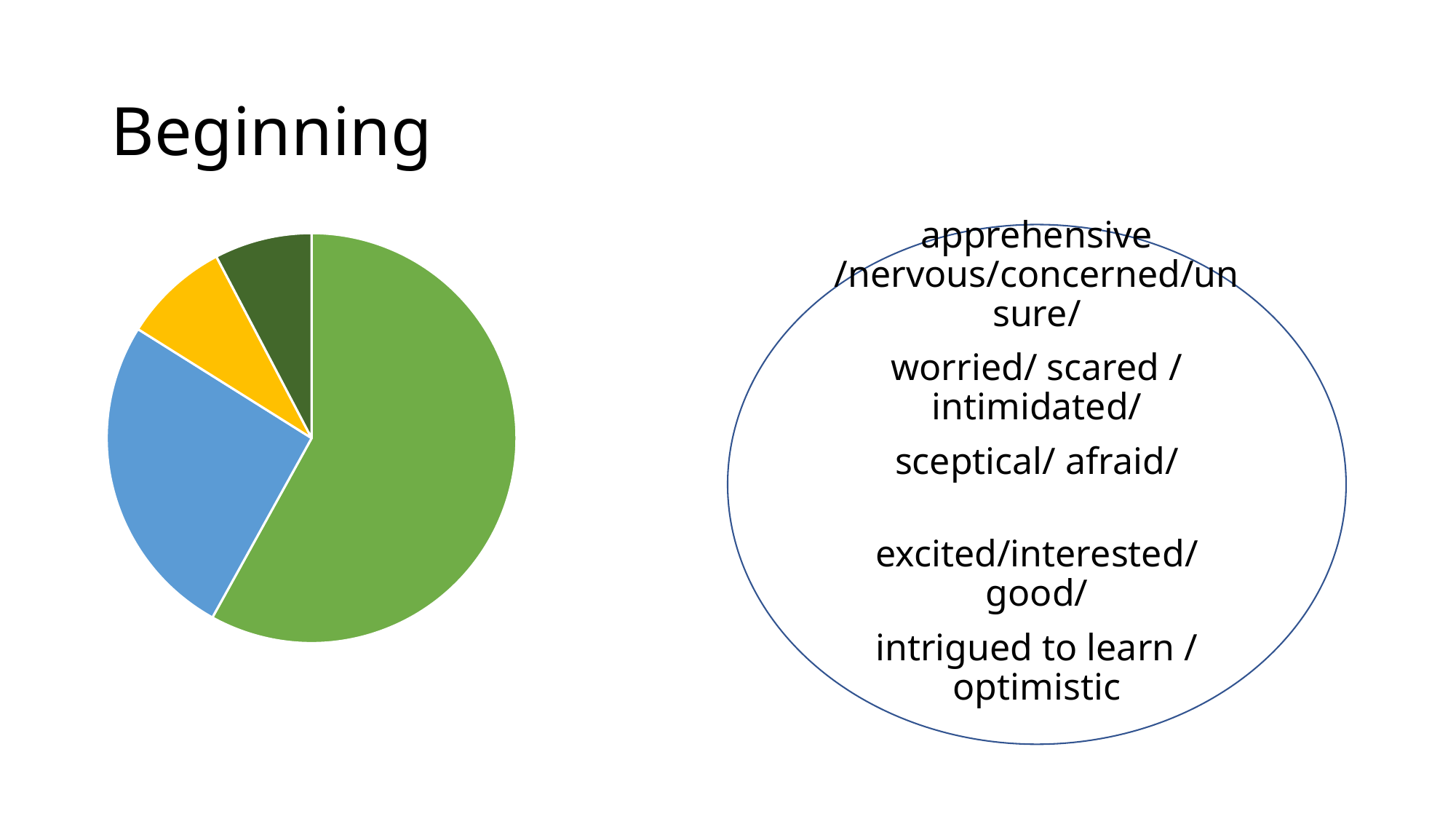
How many slices does the pie chart have? 4 What is the title text shown above the pie chart on the slide? Beginning What kind of chart is shown on the slide? pie chart Which colour slice is the largest in the pie chart? green Does the pie chart show a legend? No Which slice is larger in the pie chart, the green slice or the blue slice? green Which slice is larger in the pie chart, the blue slice or the yellow slice? blue